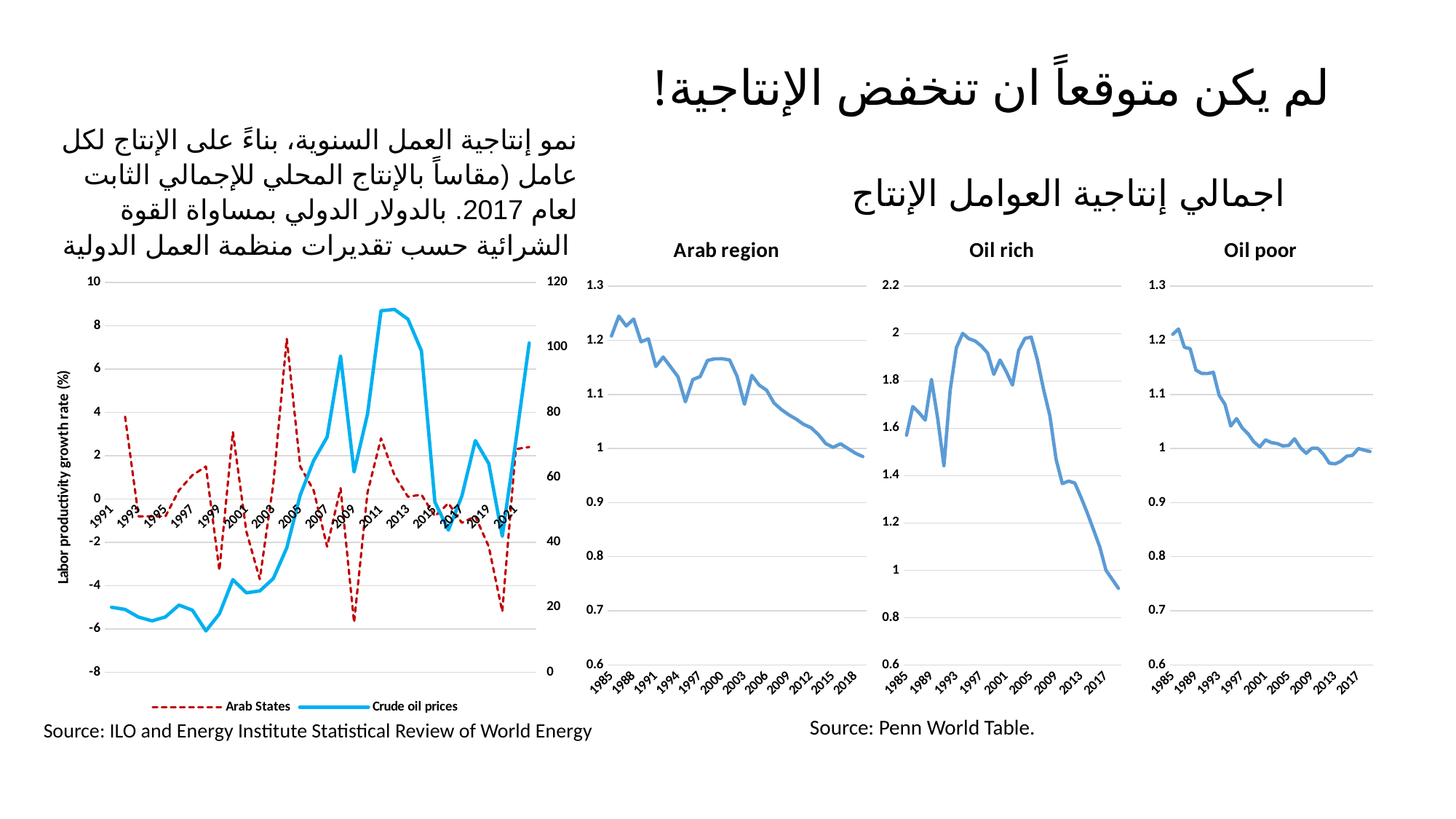
In the 'Arab region' chart, is the value for 2018 greater or less than 1? less In the left chart (Labor productivity growth rate), is the Crude oil prices value for 1998 greater or less than 20? less How many series does the legend of the left chart (Labor productivity growth rate) list? 2 In the 'Oil rich' chart, is the value for 1997 greater or less than 1.8? greater What kind of chart is the chart on the left of the slide with the 'Labor productivity growth rate (%)' axis? line chart What are the two series named in the legend of the left chart (Labor productivity growth rate)? Arab States and Crude oil prices In the 'Arab region' chart, do the values overall rise or fall from 1985 to 2018? fall